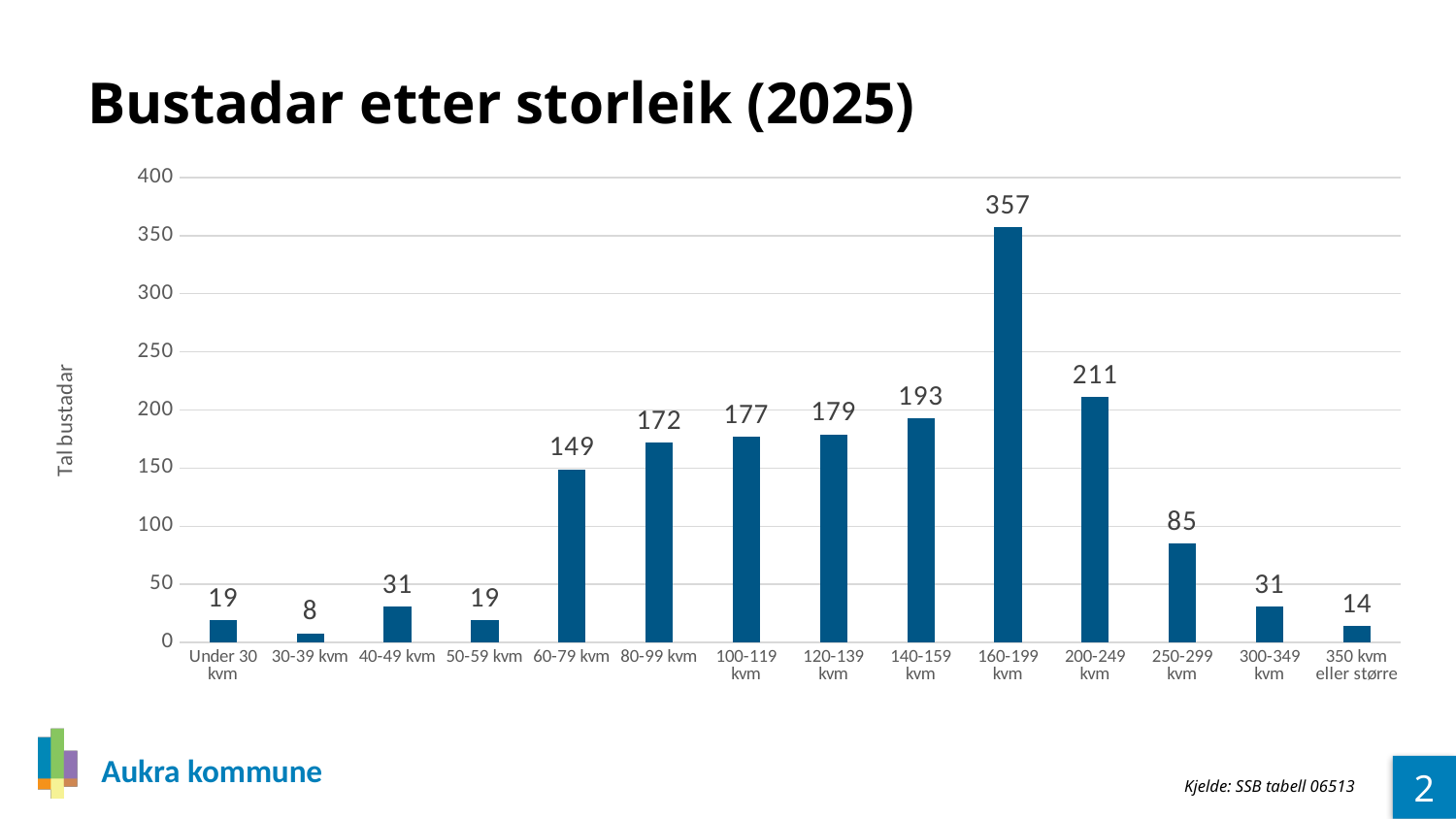
How many categories are shown on the x axis? 14 What is the title of the chart? Bustadar etter storleik (2025) What kind of chart is this? bar chart Is the value for 200-249 kvm greater or less than 200? greater What is the value for 60-79 kvm? 149 Which category has the lowest value? 30-39 kvm What is the label of the y axis? Tal bustadar Which category has the highest value? 160-199 kvm What is the difference between the values for 160-199 kvm and 200-249 kvm? 146 What is the value for 160-199 kvm? 357 What is the value for 350 kvm eller større? 14 Which is larger, the value for 140-159 kvm or the value for 250-299 kvm? 140-159 kvm